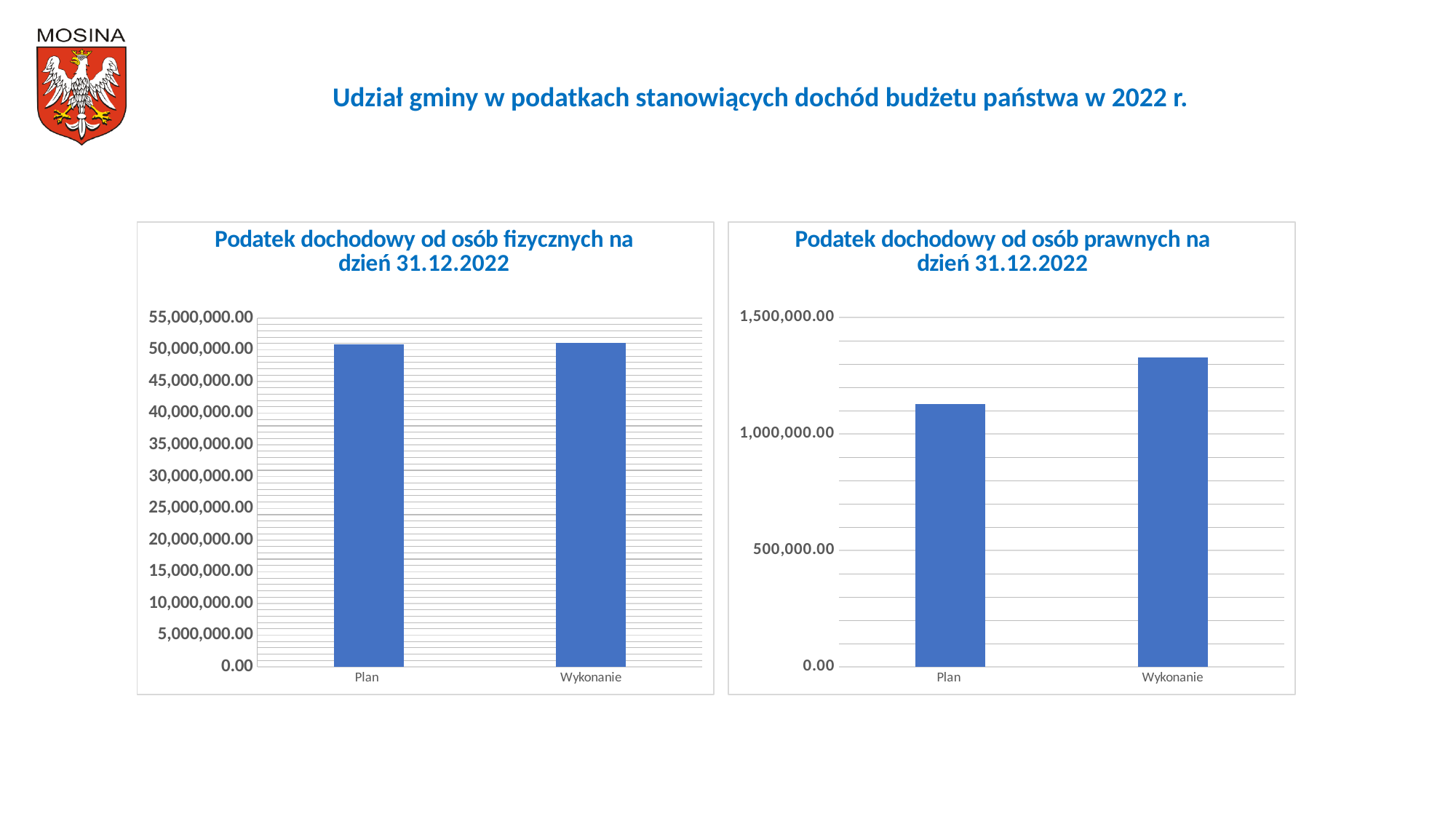
In the right chart, 'Podatek dochodowy od osób prawnych na dzień 31.12.2022', is the value for Plan greater or less than 1,000,000.00? greater What is the title of the left chart on the slide? Podatek dochodowy od osób fizycznych na dzień 31.12.2022 How many bars are shown on the right chart, 'Podatek dochodowy od osób prawnych na dzień 31.12.2022'? 2 What kind of chart is the left chart, 'Podatek dochodowy od osób fizycznych na dzień 31.12.2022'? bar chart In the right chart, 'Podatek dochodowy od osób prawnych na dzień 31.12.2022', which category has the highest value? Wykonanie What kind of chart is the right chart, 'Podatek dochodowy od osób prawnych na dzień 31.12.2022'? bar chart In the right chart, 'Podatek dochodowy od osób prawnych na dzień 31.12.2022', which category has the lowest value? Plan In the left chart, 'Podatek dochodowy od osób fizycznych na dzień 31.12.2022', is the value for Plan greater or less than 45,000,000.00? greater In the right chart, 'Podatek dochodowy od osób prawnych na dzień 31.12.2022', which is larger: Plan or Wykonanie? Wykonanie In the right chart, 'Podatek dochodowy od osób prawnych na dzień 31.12.2022', is the value for Wykonanie greater or less than 1,500,000.00? less How many categories are shown on the left chart, 'Podatek dochodowy od osób fizycznych na dzień 31.12.2022'? 2